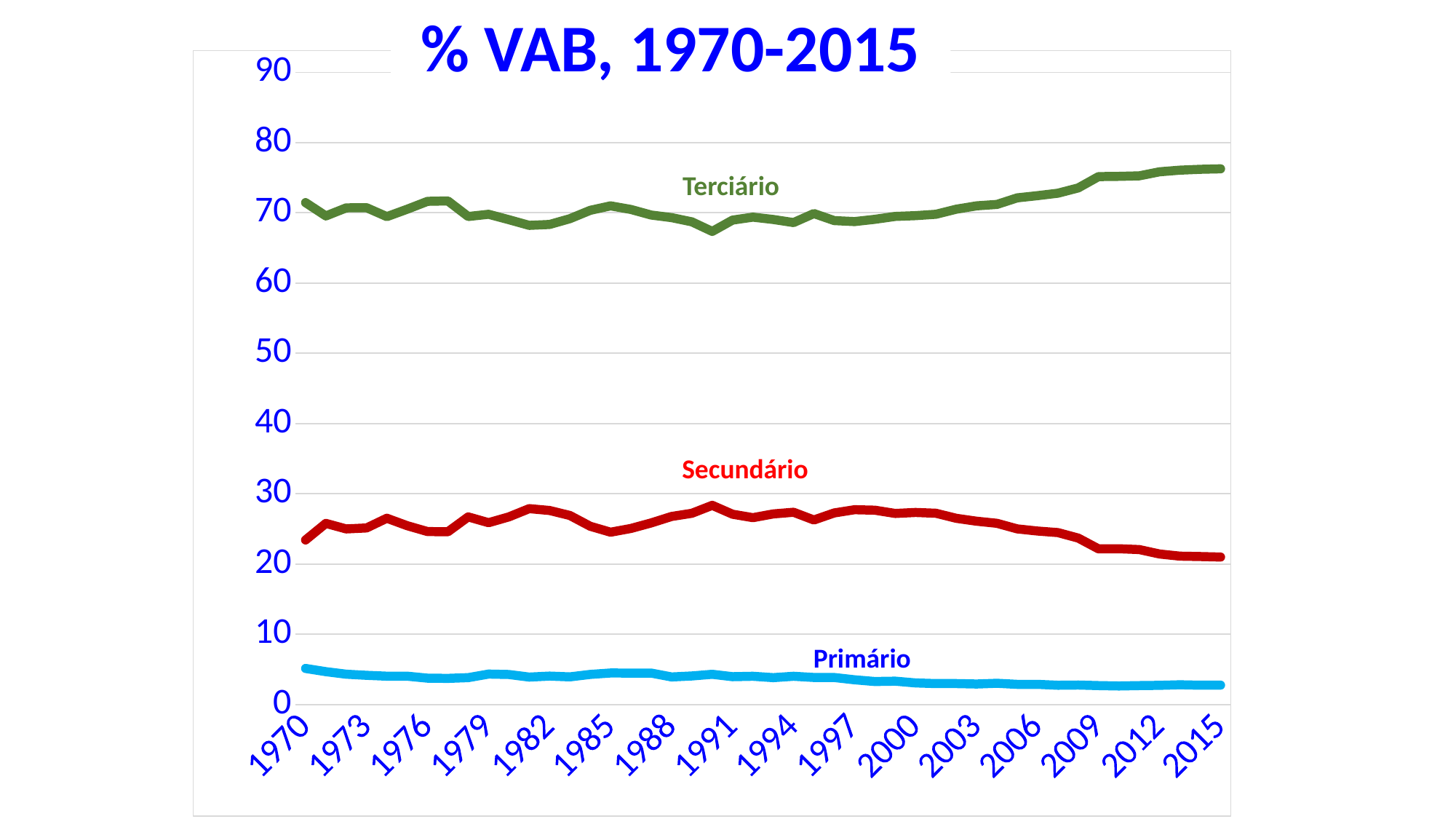
Is the value for Secundário in 1970 greater or less than 20? greater Does the Terciário series rise or fall between 2000 and 2015? rise What is the title of the chart? % VAB, 1970-2015 Is the value for Primário in 1970 greater or less than 10? less What kind of chart is shown on the slide? line chart How many series are plotted on the chart? 3 Which series has the lowest values throughout the period? Primário Which series has the highest values throughout the period? Terciário Is the value for Secundário in 2015 greater or less than 30? less Does the Secundário series rise or fall between 2000 and 2015? fall In 2015, which is larger: Terciário or Secundário? Terciário